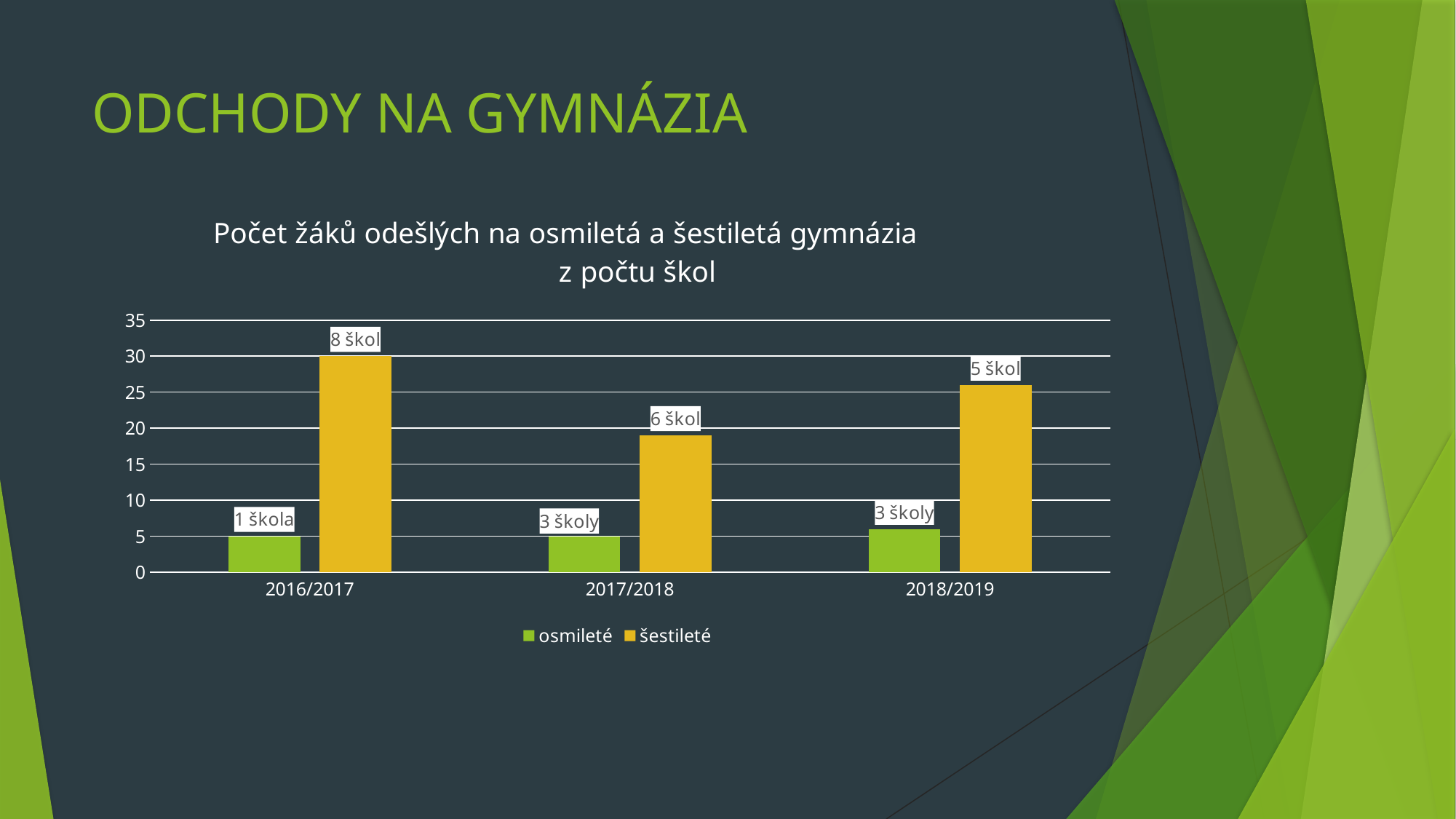
What data label is printed above the šestileté bar for 2018/2019? 5 škol In which school year is the šestileté bar the highest? 2016/2017 How many school-year categories are shown on the x axis? 3 How many series does the legend list? 2 In which school year is the šestileté bar the lowest? 2017/2018 Which series has the larger bar in 2018/2019, osmileté or šestileté? šestileté What value does the šestileté bar for 2016/2017 reach on the y axis? 30 Is the value of the šestileté bar for 2017/2018 greater or less than 20? less What data label is printed above the šestileté bar for 2016/2017? 8 škol What data label is printed above the osmileté bar for 2016/2017? 1 škola What value does the osmileté bar for 2017/2018 reach on the y axis? 5 What kind of chart is shown on the slide? bar chart